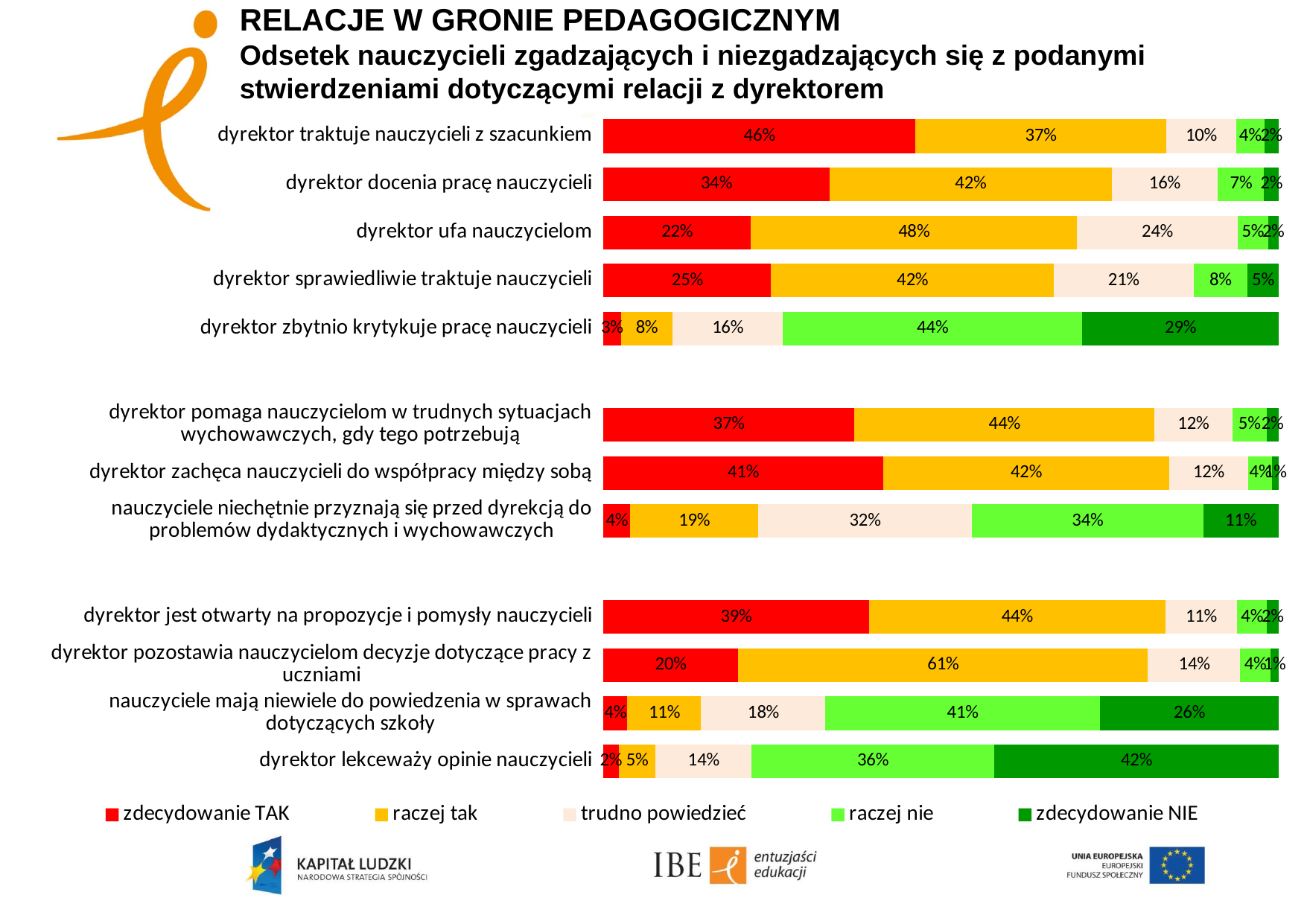
Which is larger: the 'trudno powiedzieć' value for 'dyrektor ufa nauczycielom' or for 'dyrektor docenia pracę nauczycieli'? dyrektor ufa nauczycielom What type of chart is shown on the slide? stacked bar chart What is the 'zdecydowanie TAK' value for 'dyrektor traktuje nauczycieli z szacunkiem'? 46% What is the total of the labelled segments for 'dyrektor sprawiedliwie traktuje nauczycieli'? 101% Which colour represents 'zdecydowanie NIE' in the legend? dark green Which statement has the lowest 'zdecydowanie TAK' value? dyrektor lekceważy opinie nauczycieli How many series does the legend list? 5 What is the 'zdecydowanie NIE' value for 'dyrektor lekceważy opinie nauczycieli'? 42% Which statement has the highest 'zdecydowanie TAK' value? dyrektor traktuje nauczycieli z szacunkiem What is the difference between the 'raczej nie' values for 'dyrektor zbytnio krytykuje pracę nauczycieli' and 'dyrektor lekceważy opinie nauczycieli'? 8% What is the 'raczej tak' value for 'dyrektor pozostawia nauczycielom decyzje dotyczące pracy z uczniami'? 61% How many statements (categories) are plotted in the chart? 12